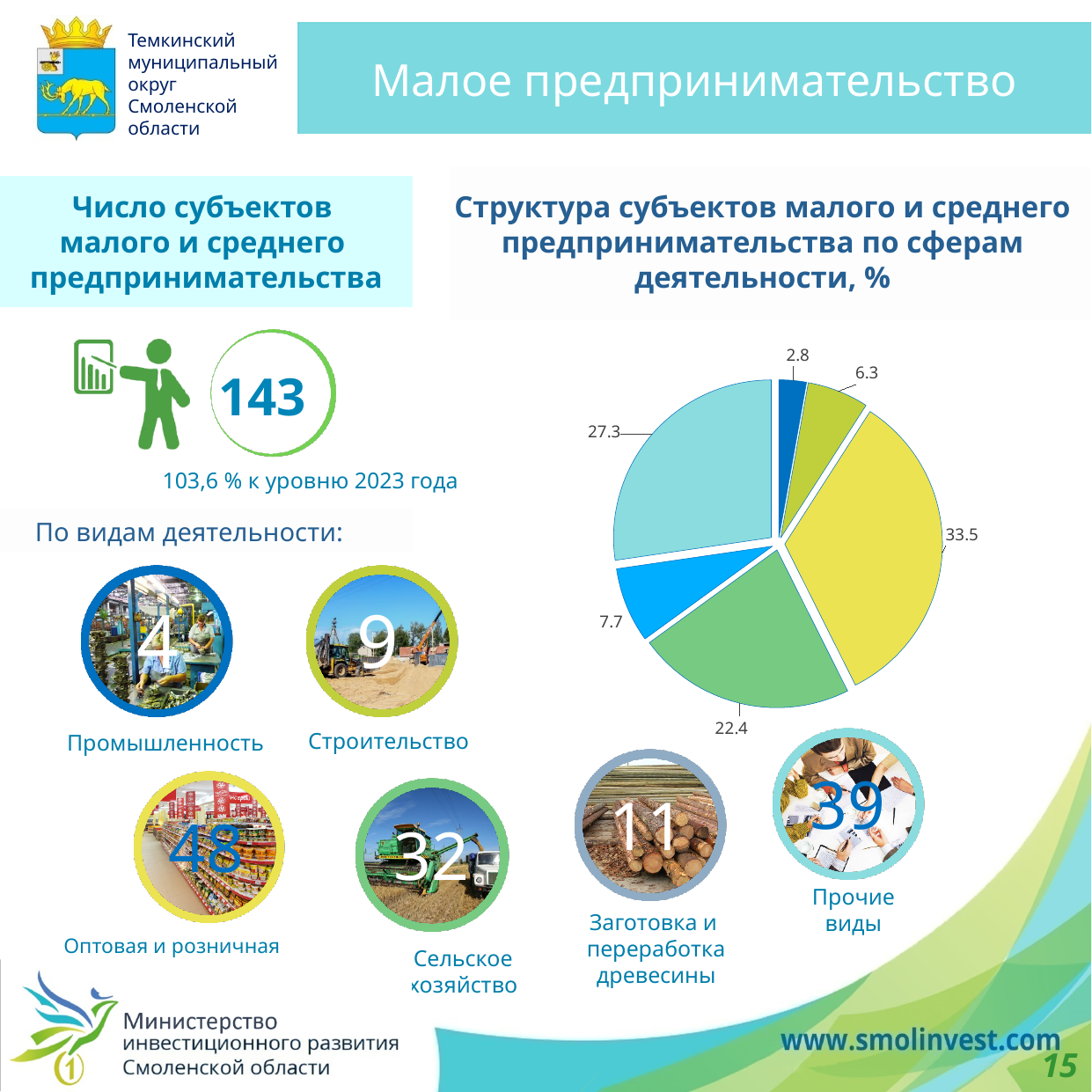
What is the difference between the largest slice (33.5) and the second-largest slice (27.3) in the pie chart? 6.2 What is the difference between the 22.4 slice and the 7.7 slice in the pie chart? 14.7 What is the value of the dark blue slice in the pie chart? 2.8 In the pie chart, which is larger: the 27.3 slice or the 22.4 slice? 27.3 How many slices does the pie chart have? 6 What is the value of the light blue (largest pale) slice in the pie chart? 27.3 In the pie chart, which is larger: the 6.3 slice or the 7.7 slice? 7.7 What is the value of the largest slice in the pie chart? 33.5 What is the value of the yellow slice in the pie chart? 33.5 What is the title of the pie chart? Структура субъектов малого и среднего предпринимательства по сферам деятельности, % What kind of chart is shown under the title "Структура субъектов малого и среднего предпринимательства по сферам деятельности, %"? pie chart What is the value of the smallest slice in the pie chart? 2.8